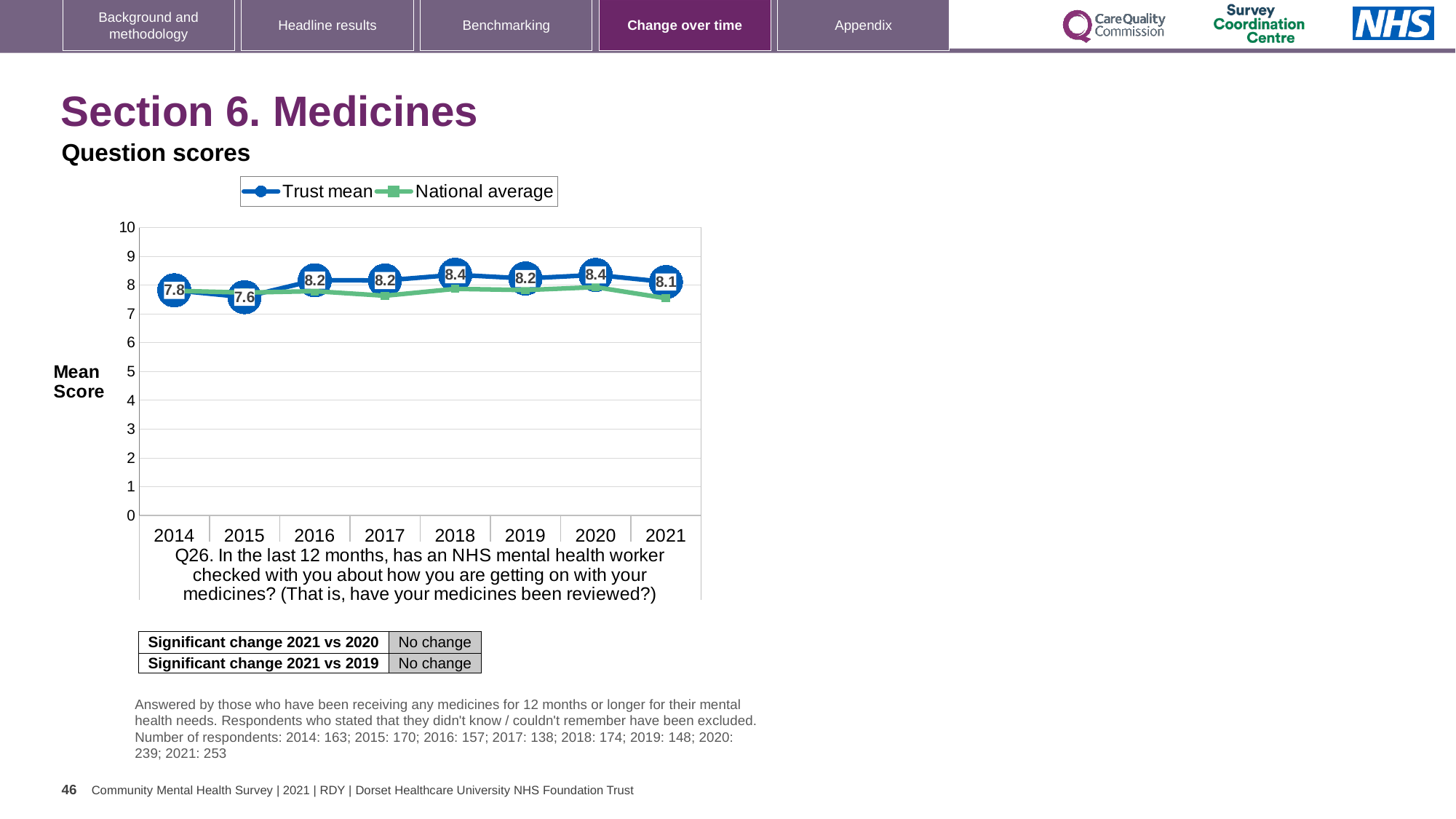
Is the National average for 2021 greater or less than 5? greater What is the Trust mean for 2014? 7.8 What is the label on the y axis? Mean Score How many years are shown on the x axis? 8 In which year is the Trust mean lowest? 2015 Which is larger, the Trust mean in 2016 or in 2015? 2016 What is the Trust mean for 2015? 7.6 What is the difference between the Trust mean in 2020 and in 2021? 0.3 What kind of chart is shown? Line chart What is the Trust mean for 2018? 8.4 How many series does the legend list? 2 What is the Trust mean for 2021? 8.1